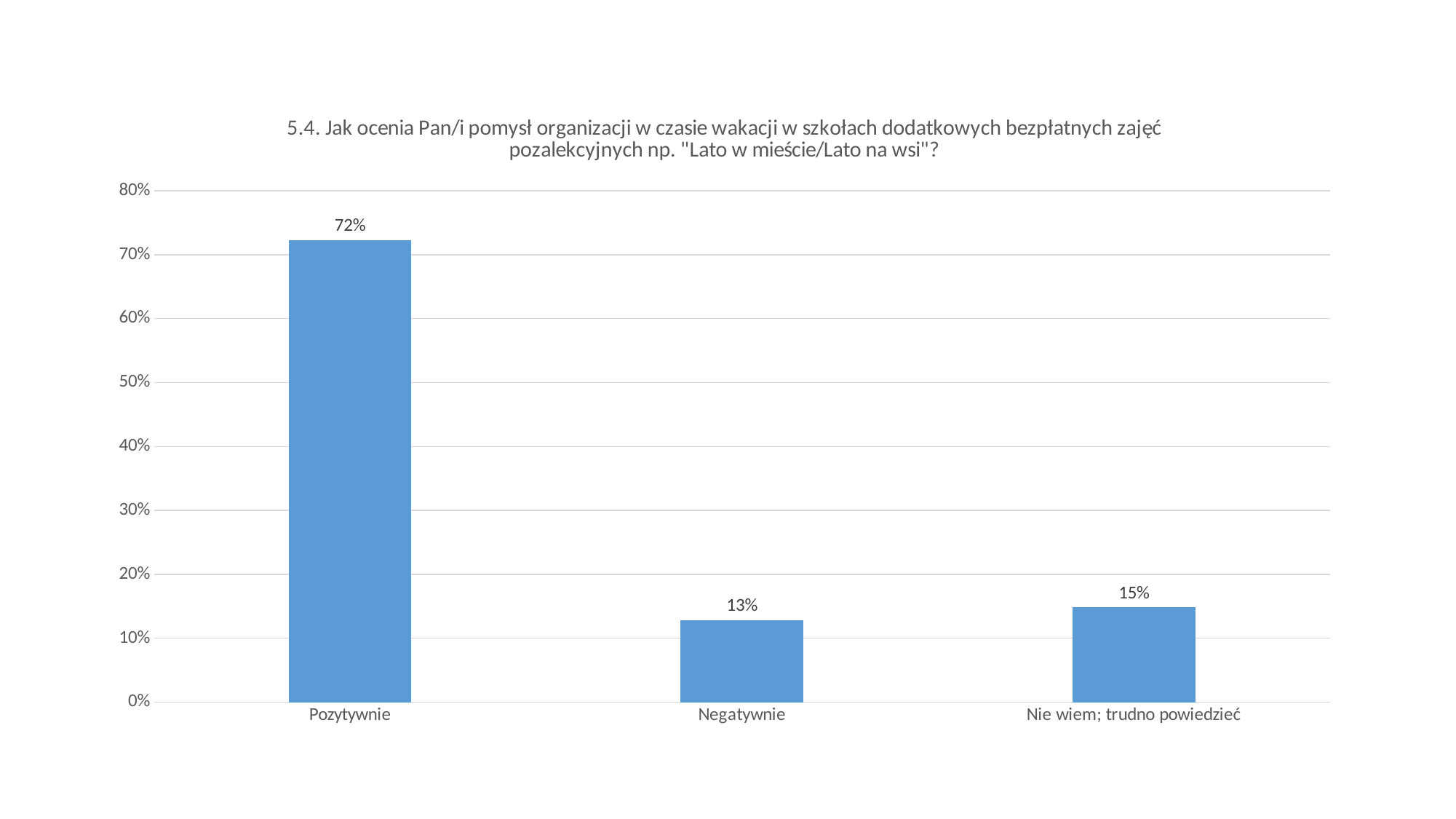
What is the value for Pozytywnie? 72% What kind of chart is shown on the slide? bar chart What is the highest value shown on the y axis? 80% Which category has the lowest value? Negatywnie How many categories are shown on the x axis? 3 What is the difference between the values for Nie wiem; trudno powiedzieć and Negatywnie? 2% What is the value for Negatywnie? 13% Which category has the highest value? Pozytywnie What is the value for Nie wiem; trudno powiedzieć? 15% Is the value for Pozytywnie greater or less than 70%? greater What is the difference between the values for Pozytywnie and Negatywnie? 59% Which is larger, the value for Negatywnie or the value for Nie wiem; trudno powiedzieć? Nie wiem; trudno powiedzieć